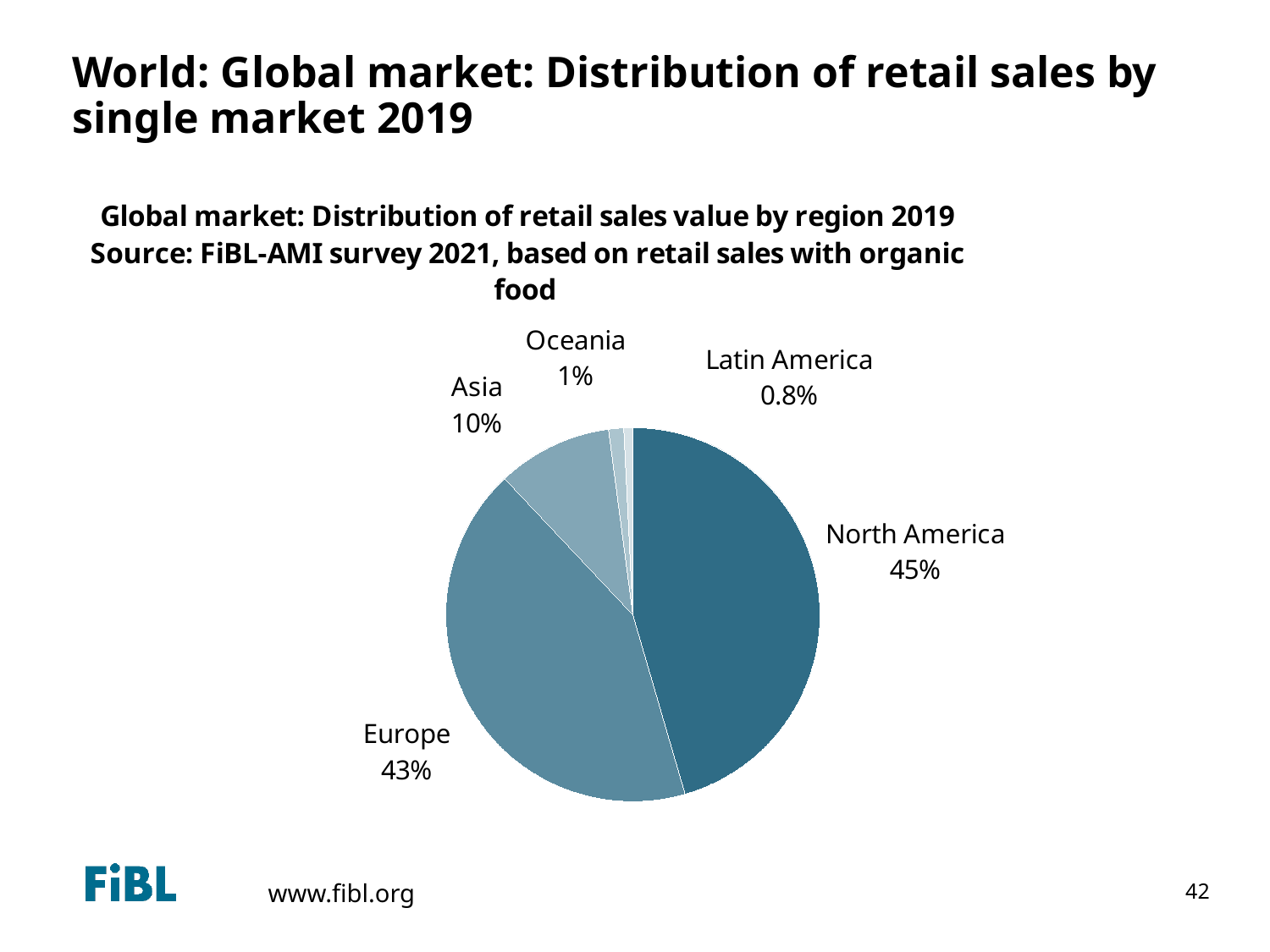
What share of retail sales value does Asia hold in the pie chart? 10% Which has a larger share of retail sales value, Asia or Oceania? Asia What is the difference in percentage points between North America's and Europe's shares? 2 percentage points What is the source cited in the chart title? FiBL-AMI survey 2021 Which region has the smallest share of retail sales value in the pie chart? Latin America How many regions are shown in the pie chart? 5 What share of retail sales value does Oceania hold in the pie chart? 1% What share of retail sales value does North America hold in the pie chart? 45% Which region has the largest share of retail sales value in the pie chart? North America What share of retail sales value does Europe hold in the pie chart? 43% What type of chart is shown on the slide? Pie chart What share of retail sales value does Latin America hold in the pie chart? 0.8%